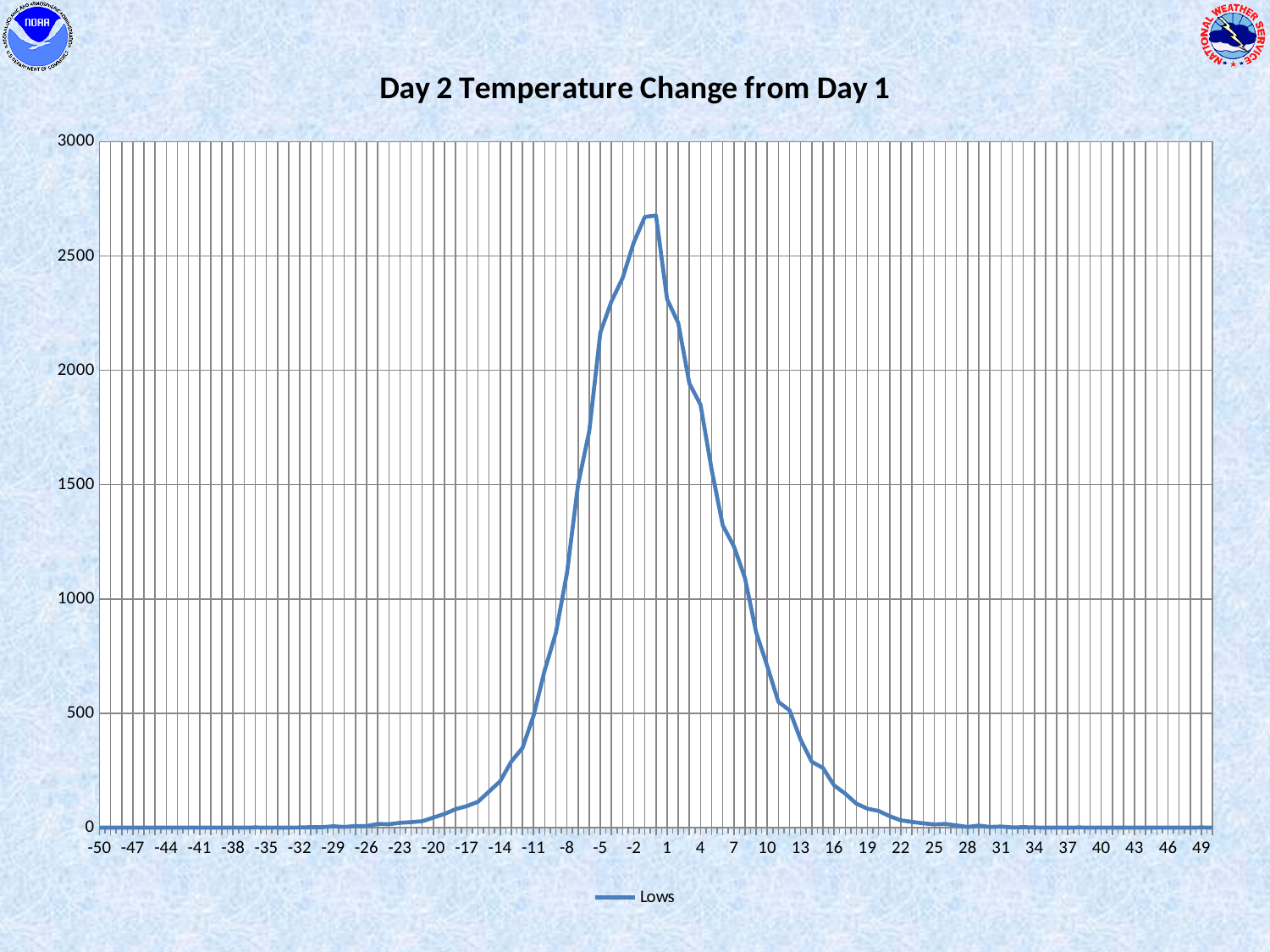
Do the values rise or fall along the x axis from 1 to 49? fall Is the value for 16 greater or less than 500? less Is the value for -5 greater or less than 2000? greater How many series does the legend list? 1 Is the value for 4 greater or less than 1500? greater Do the values rise or fall along the x axis from -50 to -2? rise What is the name of the series shown in the legend? Lows What is the title of the chart? Day 2 Temperature Change from Day 1 What kind of chart is shown on the slide? line chart